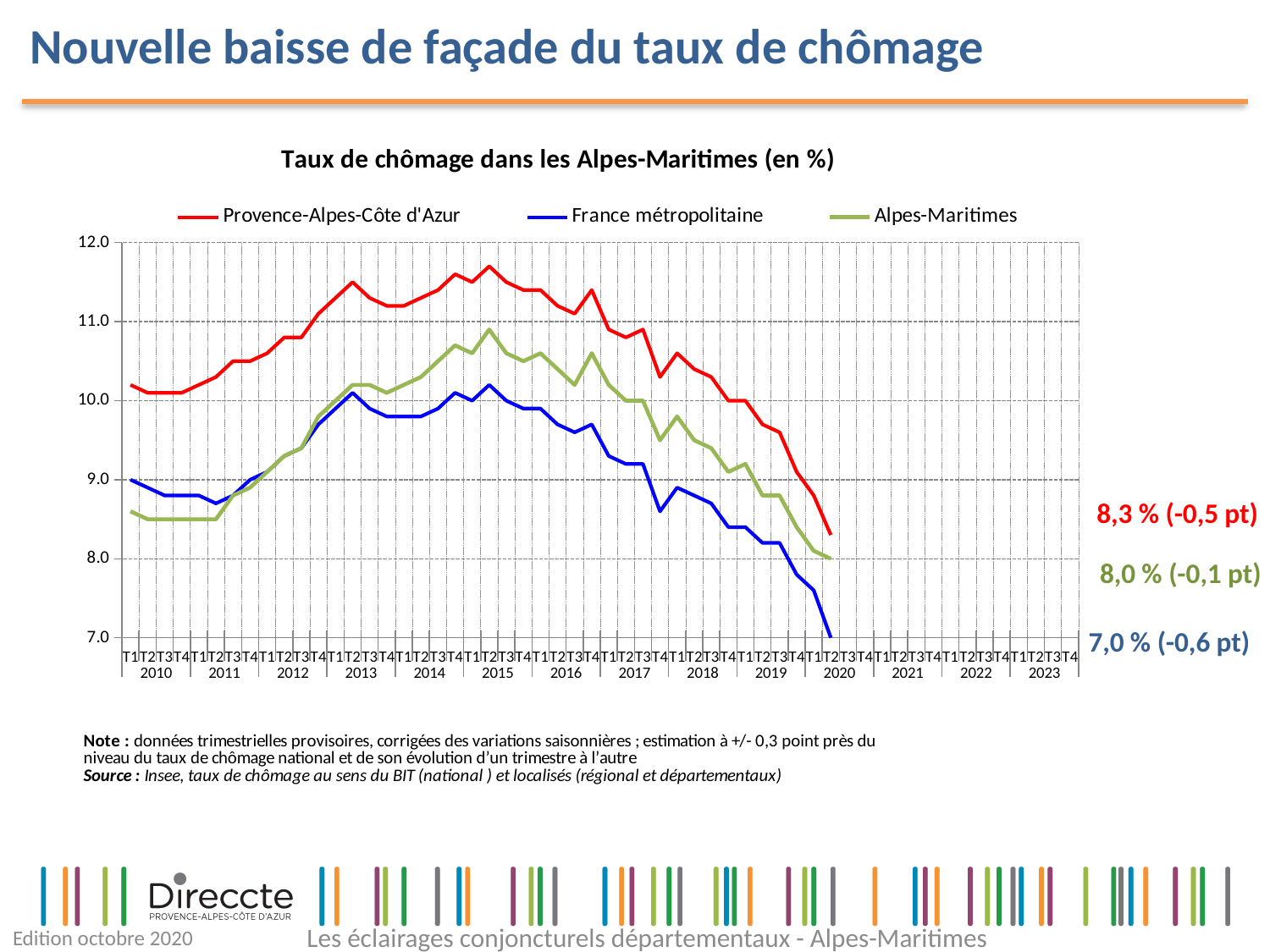
What is the difference between the latest values of Provence-Alpes-Côte d'Azur and France métropolitaine? 1,3 pt How many series does the legend list? 3 What is the latest value shown for Alpes-Maritimes at the end of the series? 8,0 % Is the value for Alpes-Maritimes in T1 2010 greater or less than 9.0? less What change over the last quarter is printed next to the France métropolitaine line? -0,6 pt What is the latest value shown for Provence-Alpes-Côte d'Azur at the end of the series? 8,3 % Which series has the lowest value at the end of the chart? France métropolitaine What is the latest value shown for France métropolitaine at the end of the series? 7,0 % At the end of the series, which is higher: Provence-Alpes-Côte d'Azur or France métropolitaine? Provence-Alpes-Côte d'Azur Is the peak value of Provence-Alpes-Côte d'Azur in 2015 greater or less than 11.0? greater What kind of chart is shown on the slide? line chart Do the unemployment rates rise or fall between 2017 and 2020? fall